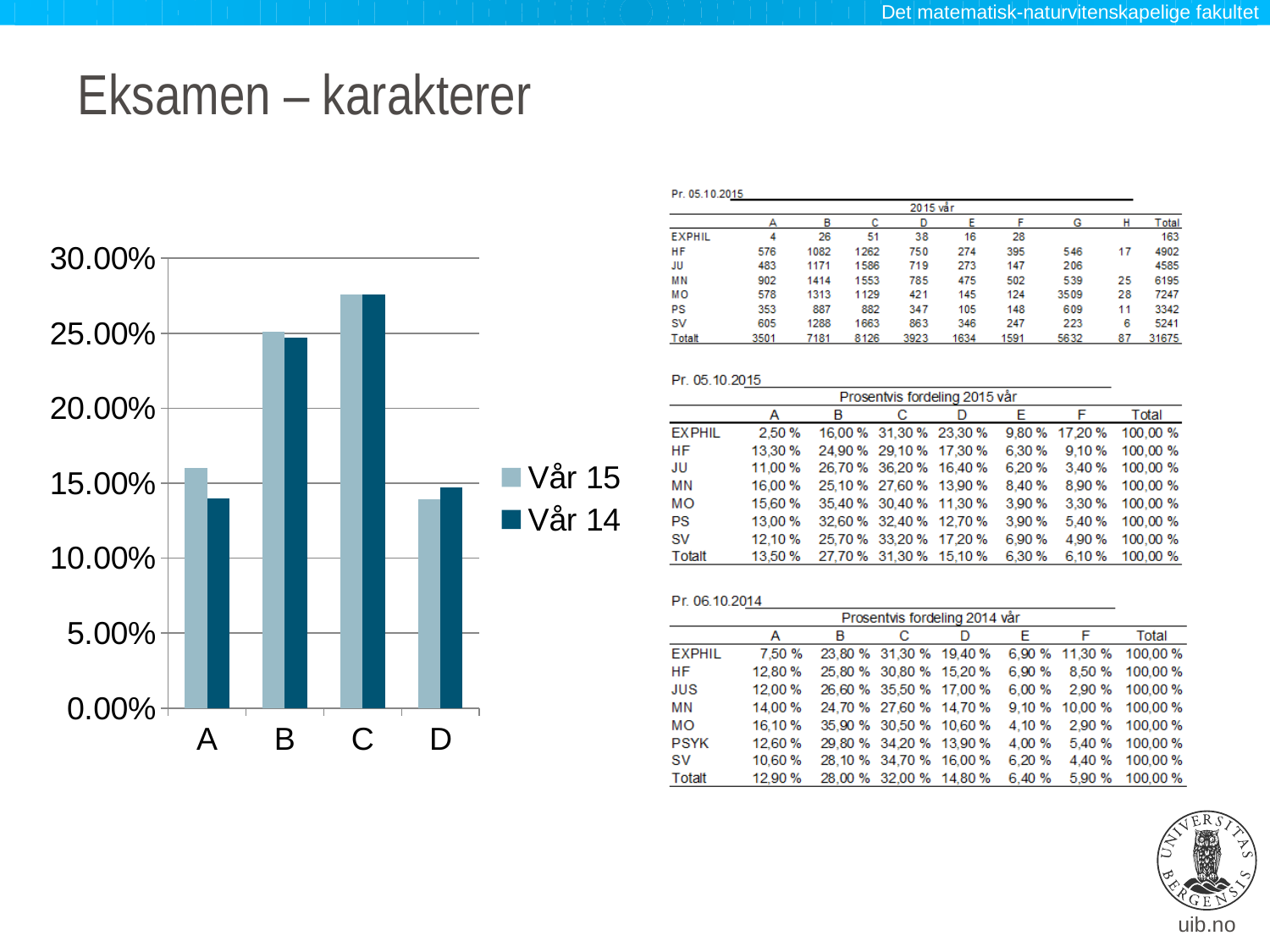
Is the Vår 15 value for grade C greater or less than 25.00%? greater What kind of chart is shown on the slide? bar chart Is the Vår 15 value for grade A greater or less than 15.00%? greater How many series does the chart's legend list? 2 Which grade has the lowest value for Vår 15? D For grade A, which series has the larger value, Vår 15 or Vår 14? Vår 15 What are the two legend entries of the chart? Vår 15 and Vår 14 Which grade has the highest value for Vår 14? C Which grade has the highest value for Vår 15? C For grade D, which series has the larger value, Vår 15 or Vår 14? Vår 14 How many grade categories are shown on the x axis of the chart? 4 Is the Vår 14 value for grade A greater or less than 15.00%? less